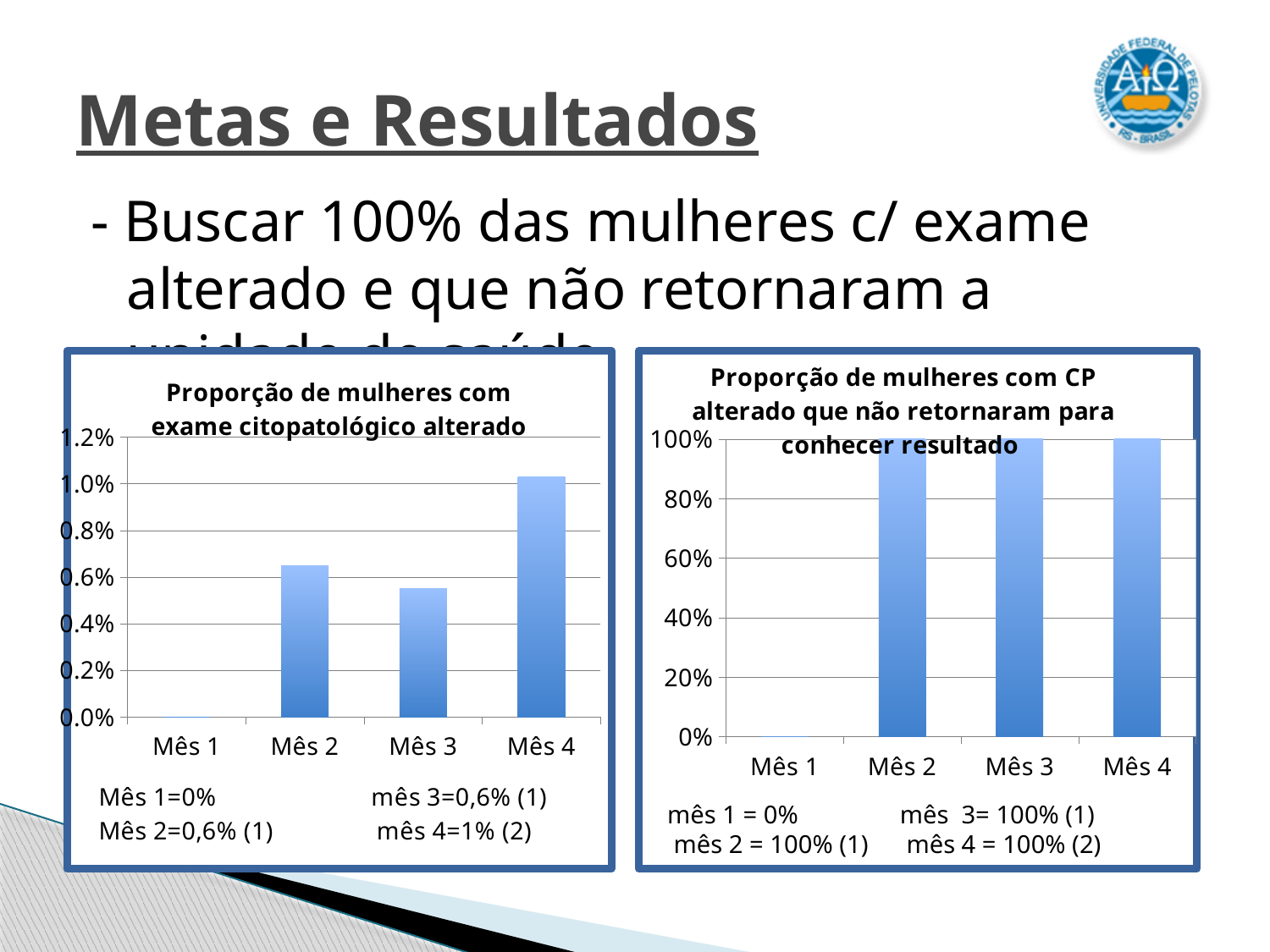
What kind of chart is the right chart (Proporção de mulheres com CP alterado que não retornaram para conhecer resultado)? Bar chart On the left chart (Proporção de mulheres com exame citopatológico alterado), which month has the highest value? Mês 4 On the left chart (Proporção de mulheres com exame citopatológico alterado), is the value for Mês 2 greater or less than 0.4%? greater On the right chart (Proporção de mulheres com CP alterado que não retornaram para conhecer resultado), what is the difference between the values for Mês 2 and Mês 1? 100% On the left chart (Proporção de mulheres com exame citopatológico alterado), is the value for Mês 4 greater or less than 0.8%? greater On the right chart (Proporção de mulheres com CP alterado que não retornaram para conhecer resultado), what is the value for Mês 3? 100% On the right chart (Proporção de mulheres com CP alterado que não retornaram para conhecer resultado), what is the value for Mês 1? 0% On the left chart (Proporção de mulheres com exame citopatológico alterado), which is larger, the value for Mês 2 or Mês 3? Mês 2 On the left chart (Proporção de mulheres com exame citopatológico alterado), is the value for Mês 3 greater or less than 0.8%? less On the right chart (Proporção de mulheres com CP alterado que não retornaram para conhecer resultado), which month has the lowest value? Mês 1 On the left chart (Proporção de mulheres com exame citopatológico alterado), how many months are shown on the x axis? 4 On the left chart (Proporção de mulheres com exame citopatológico alterado), which month has the lowest value? Mês 1